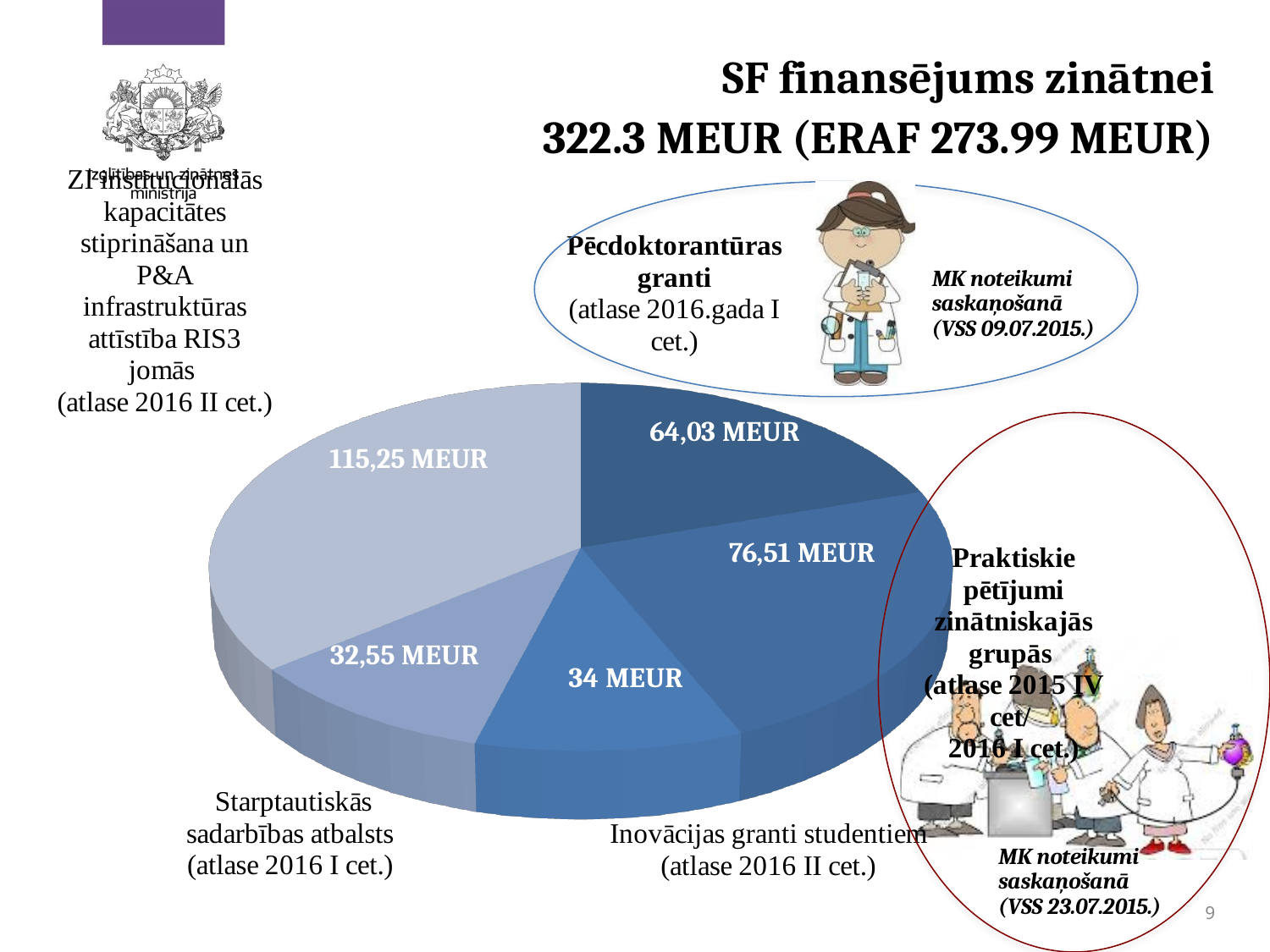
What is the difference between the Inovācijas granti studentiem slice and the Starptautiskās sadarbības atbalsts slice? 1,45 MEUR What is the value of the smallest slice of the pie chart? 32,55 MEUR What value is shown for the Inovācijas granti studentiem slice? 34 MEUR What value is shown for the Praktiskie pētījumi zinātniskajās grupās slice? 76,51 MEUR What value is shown for the Pēcdoktorantūras granti slice? 64,03 MEUR What is the value of the largest slice of the pie chart? 115,25 MEUR Which is larger: the Pēcdoktorantūras granti slice or the Praktiskie pētījumi zinātniskajās grupās slice? Praktiskie pētījumi zinātniskajās grupās What kind of chart is shown on the slide? pie chart What value is shown for the Starptautiskās sadarbības atbalsts slice? 32,55 MEUR What total amount of SF funding for science is stated in the slide title? 322.3 MEUR How many slices does the pie chart have? 5 What is the difference between the 115,25 MEUR slice and the 76,51 MEUR slice? 38,74 MEUR